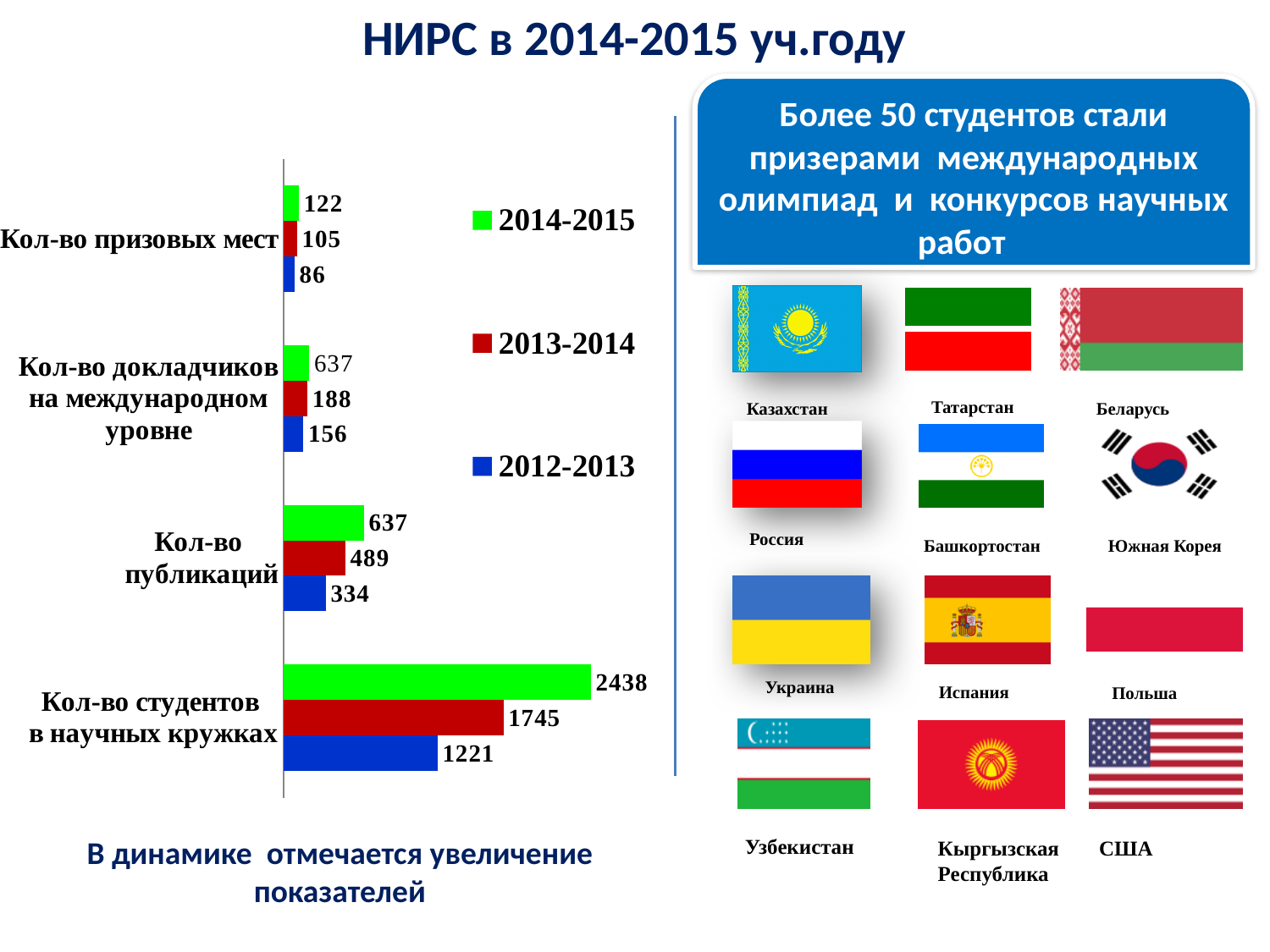
What is the value for 'Кол-во публикаций' in 2013-2014? 489 How many series does the chart legend list? 3 What is the value for 'Кол-во призовых мест' in 2012-2013? 86 What is the value for 'Кол-во студентов в научных кружках' in 2014-2015? 2438 What is the difference between the 2014-2015 and 2012-2013 values for 'Кол-во студентов в научных кружках'? 1217 What kind of chart is shown on the slide? bar chart How many categories are shown on the chart? 4 Which category has the lowest value in the 2012-2013 series? Кол-во призовых мест Which series is shown in green in the chart legend? 2014-2015 For 'Кол-во публикаций', which is larger: the 2013-2014 value or the 2012-2013 value? 2013-2014 Which category has the highest value in the 2014-2015 series? Кол-во студентов в научных кружках What is the value for 'Кол-во докладчиков на международном уровне' in 2013-2014? 188